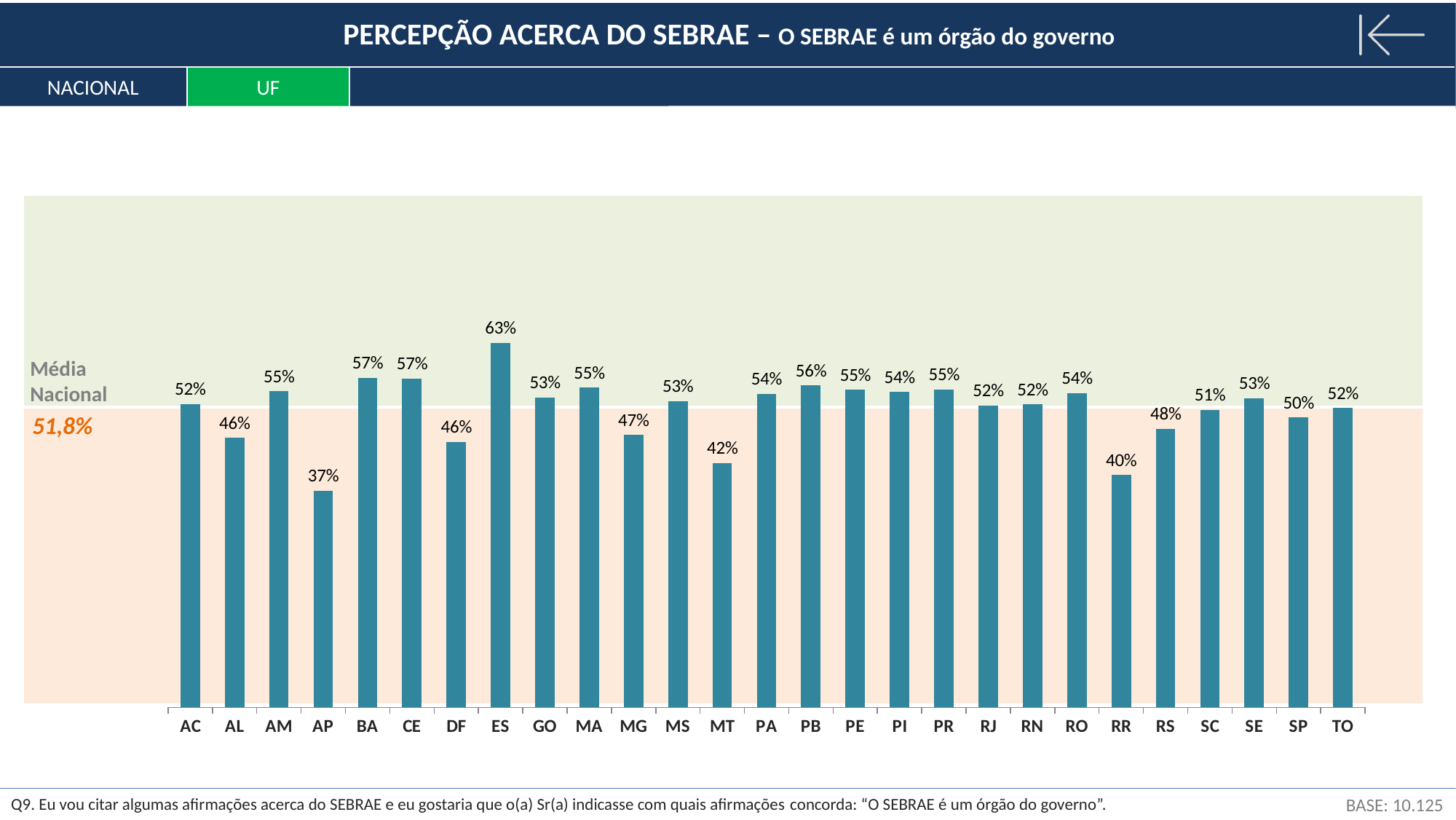
What is the value for AP? 37% What is the value for ES? 63% What kind of chart is shown on the slide? Bar chart What is the difference between the values for BA and DF? 11% Which state has the highest value? ES What is the value for PB? 56% Which is larger, the value for MT or the value for MG? MG Which state has the lowest value? AP What is the difference between the values for ES and AP? 26% What is the value of the Média Nacional shown on the chart? 51,8% How many states (categories) are shown on the x axis? 27 What is the value for RR? 40%